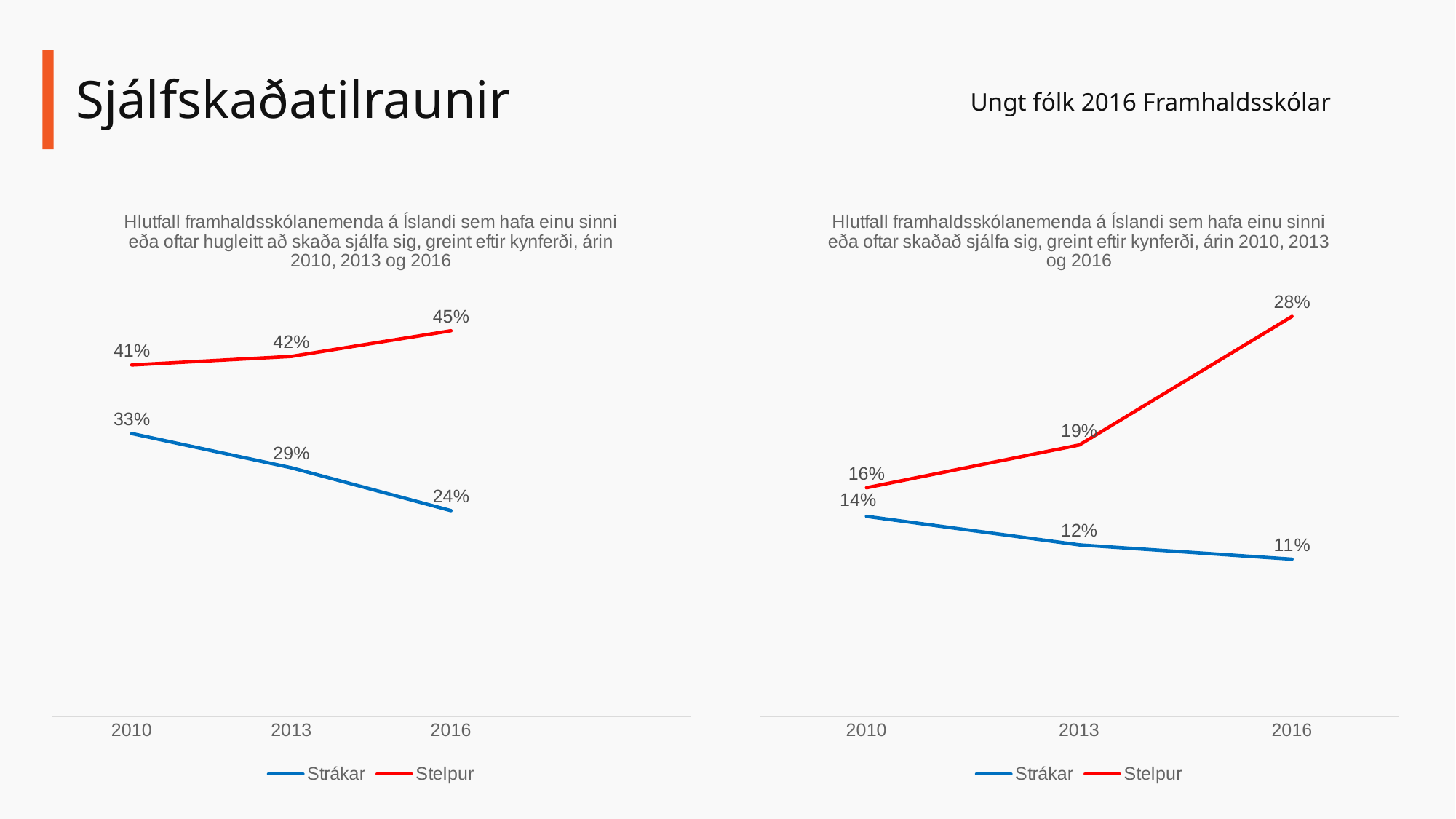
In the right chart (skaðað sjálfa sig), which series has the larger value in 2010, Strákar or Stelpur? Stelpur In the right chart (skaðað sjálfa sig), what is the value for Stelpur in 2013? 19% In the right chart (skaðað sjálfa sig), in which year is the Stelpur value highest? 2016 How many series does the legend of the right chart (skaðað sjálfa sig) list? 2 In the left chart (hugleitt að skaða sjálfa sig), what is the difference between Stelpur and Strákar in 2016? 21 percentage points In the right chart (skaðað sjálfa sig), what is the difference between the Stelpur values in 2016 and 2010? 12 percentage points In the right chart (skaðað sjálfa sig), what is the value for Strákar in 2016? 11% In the left chart (hugleitt að skaða sjálfa sig), in which year is the Strákar value lowest? 2016 What kind of chart is the left chart (hugleitt að skaða sjálfa sig)? Line chart In the left chart (hugleitt að skaða sjálfa sig), what is the value for Strákar in 2010? 33% In the left chart (hugleitt að skaða sjálfa sig), does the Strákar series rise or fall from 2010 to 2016? Fall In the left chart (hugleitt að skaða sjálfa sig), what is the value for Stelpur in 2016? 45%